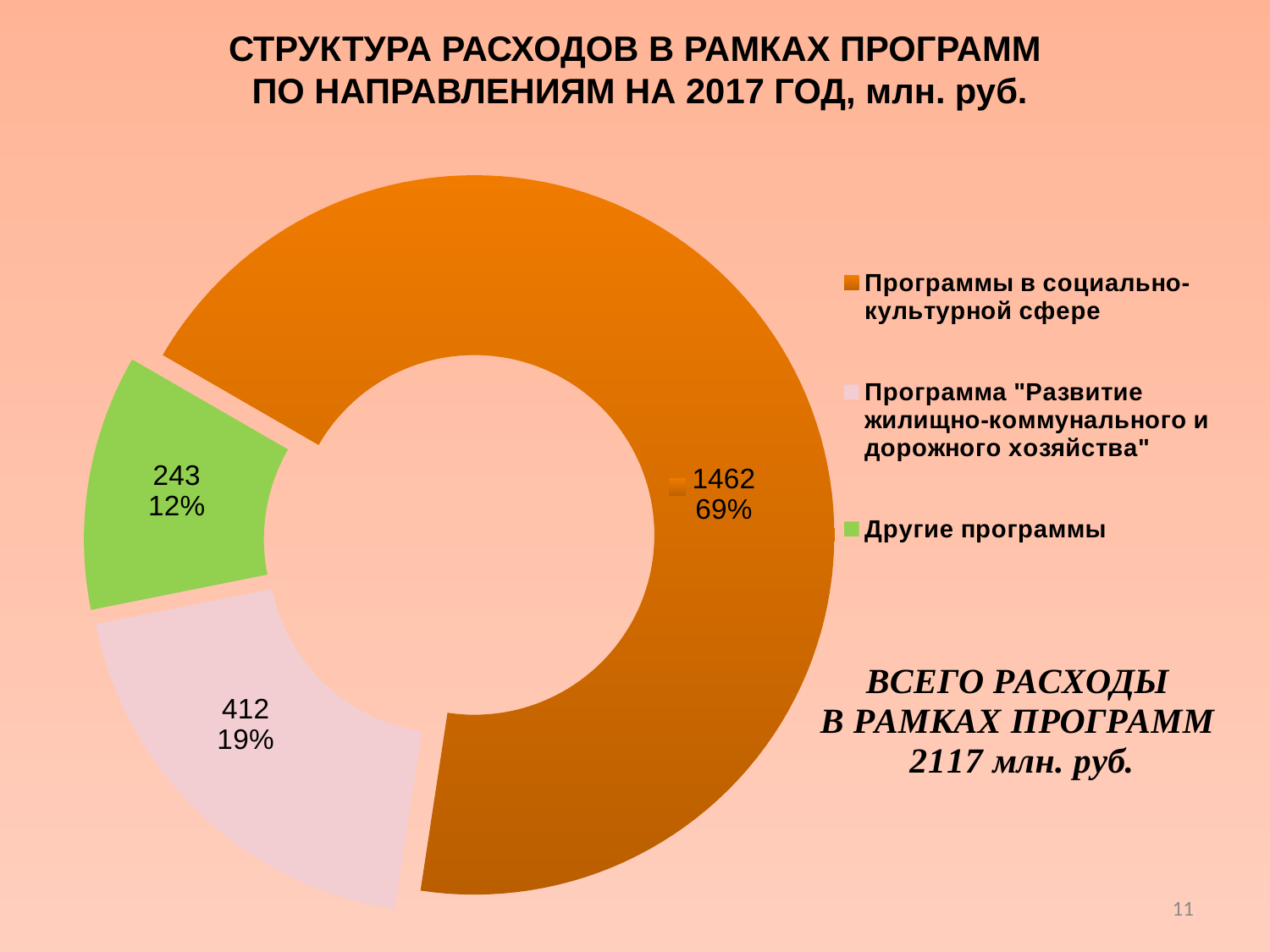
What kind of chart is shown on the slide? Doughnut (pie) chart What is the difference between the values for "Программы в социально-культурной сфере" and "Программа "Развитие жилищно-коммунального и дорожного хозяйства""? 1050 What value is shown for "Программа "Развитие жилищно-коммунального и дорожного хозяйства""? 412 Which category has the largest value? Программы в социально-культурной сфере What total expenditure within programs is stated on the slide? 2117 млн. руб. What value is shown for "Другие программы"? 243 What share of the chart does "Программы в социально-культурной сфере" represent? 69% What share of the chart does "Другие программы" represent? 12% Which is larger: the value for "Программа "Развитие жилищно-коммунального и дорожного хозяйства"" or for "Другие программы"? Программа "Развитие жилищно-коммунального и дорожного хозяйства" How many categories does the chart show? 3 Which category has the smallest value? Другие программы What value is shown for "Программы в социально-культурной сфере"? 1462